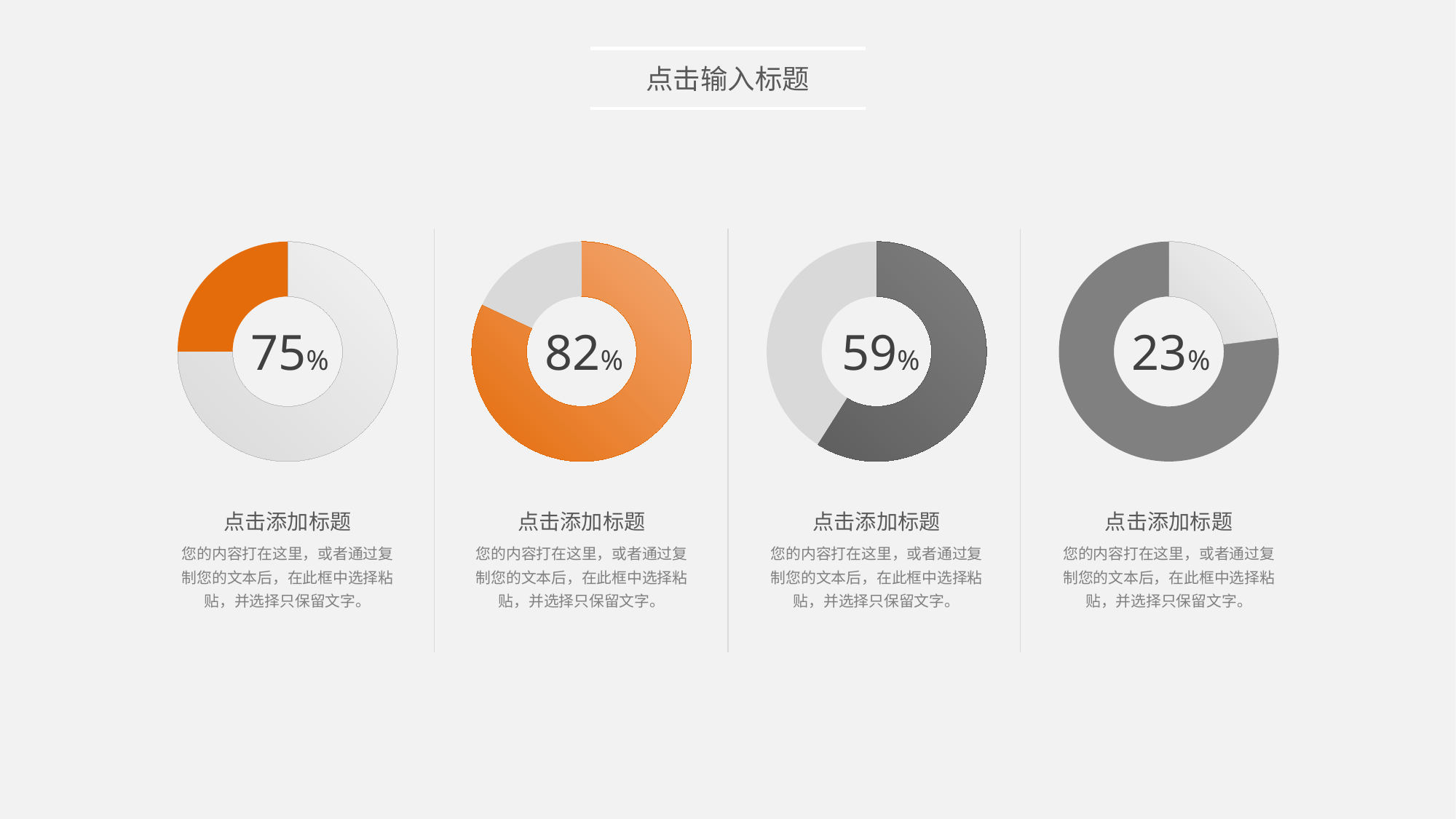
What colour is the filled portion of the second donut chart from the left? Orange What value is shown in the centre of the second donut chart from the left? 82% What value is shown in the centre of the leftmost donut chart? 75% Which of the four donut charts shows the lowest percentage? The rightmost (23%) What is the difference between the percentage in the leftmost donut chart and the percentage in the third donut chart from the left? 16% Which shows a larger percentage, the leftmost donut chart or the third donut chart from the left? The leftmost (75%) Which of the four donut charts shows the highest percentage? The second from the left (82%) What kind of chart is used for each of the four figures on the slide? Donut chart What is the difference between the percentage in the second donut chart from the left and the percentage in the rightmost donut chart? 59% What value is shown in the centre of the rightmost donut chart? 23% What value is shown in the centre of the third donut chart from the left? 59% How many donut charts are on the slide? 4